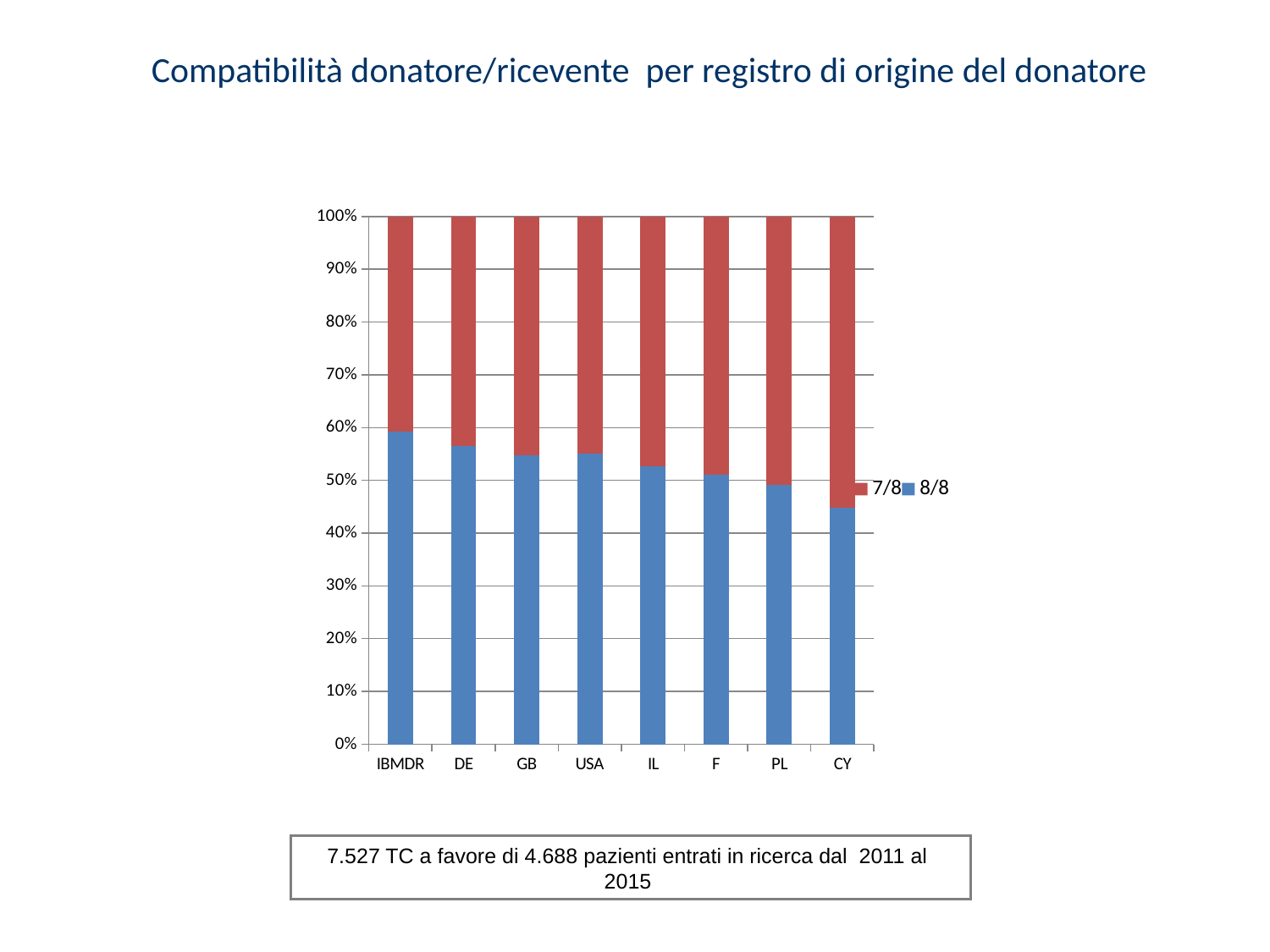
Is the 8/8 share for IBMDR greater or less than 50%? greater What kind of chart is shown on the slide? stacked bar chart Which has a larger 8/8 share, IBMDR or CY? IBMDR Does the 8/8 share rise or fall moving from IBMDR to CY along the x axis? fall Is the 8/8 share for CY greater or less than 50%? less Is the 7/8 share for CY greater or less than 50%? greater How many series does the legend list? 2 Which colour represents the 7/8 series in the legend? red Which registry has the lowest share of 8/8 compatibility? CY Which registry has the highest share of 8/8 compatibility? IBMDR What is the total of each stacked bar? 100% How many registries (categories) are shown on the x axis? 8